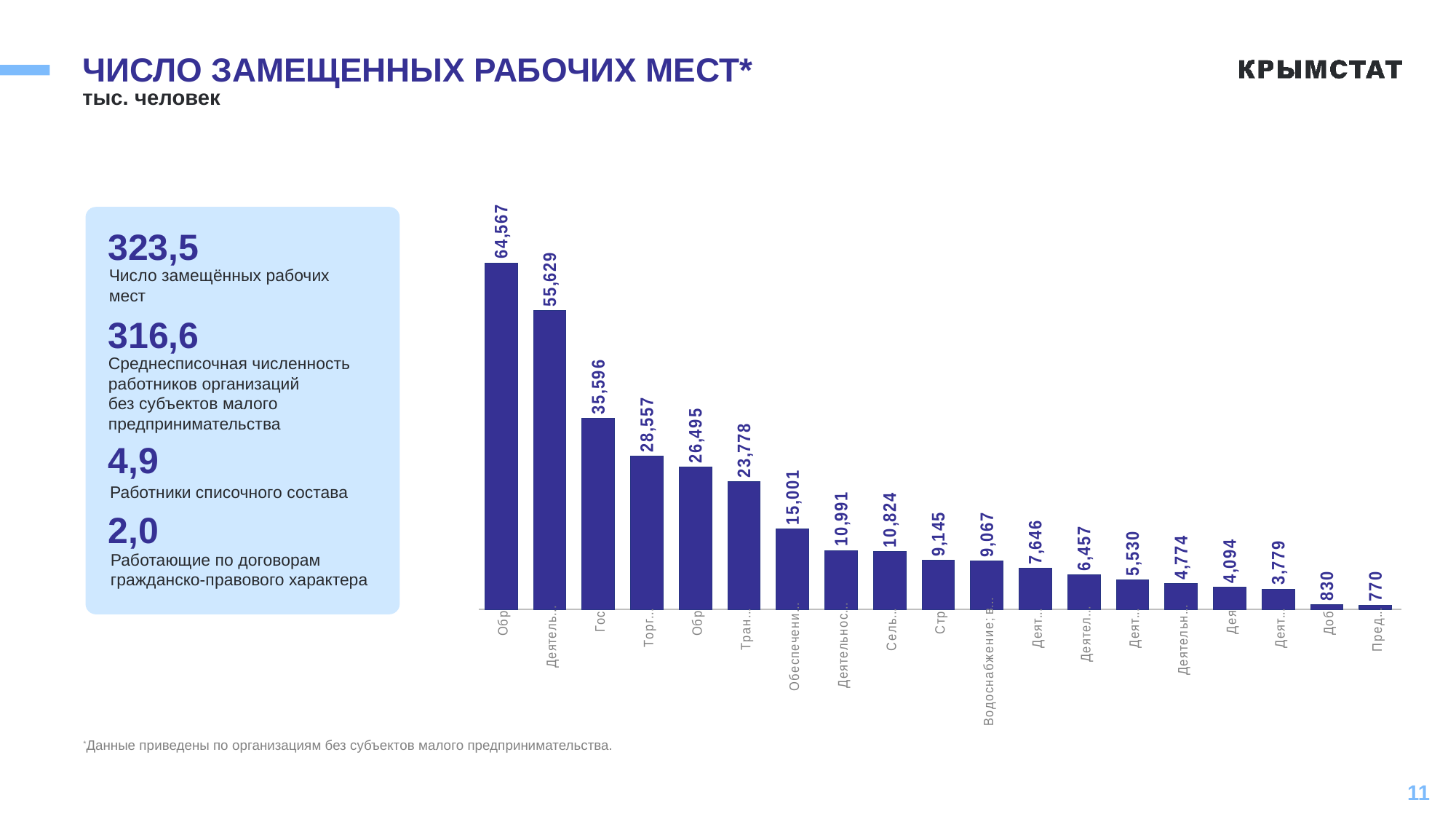
Which is larger: the second bar from the left or the third bar from the left? the second bar (55,629) What is the lowest value shown on the chart? 770 What is the value of the third bar from the left? 35,596 What kind of chart is shown on the slide? bar chart What is the difference between the two rightmost bars? 60 What is the difference between the tallest bar and the second tallest bar? 8,938 What is the value of the seventh bar from the left? 15,001 What is the highest value shown on the chart? 64,567 What is the value of the second bar from the right? 830 How many bars are plotted on the chart? 19 Do the bar values rise or fall from left to right along the x axis? fall What unit is stated under the chart title? тыс. человек